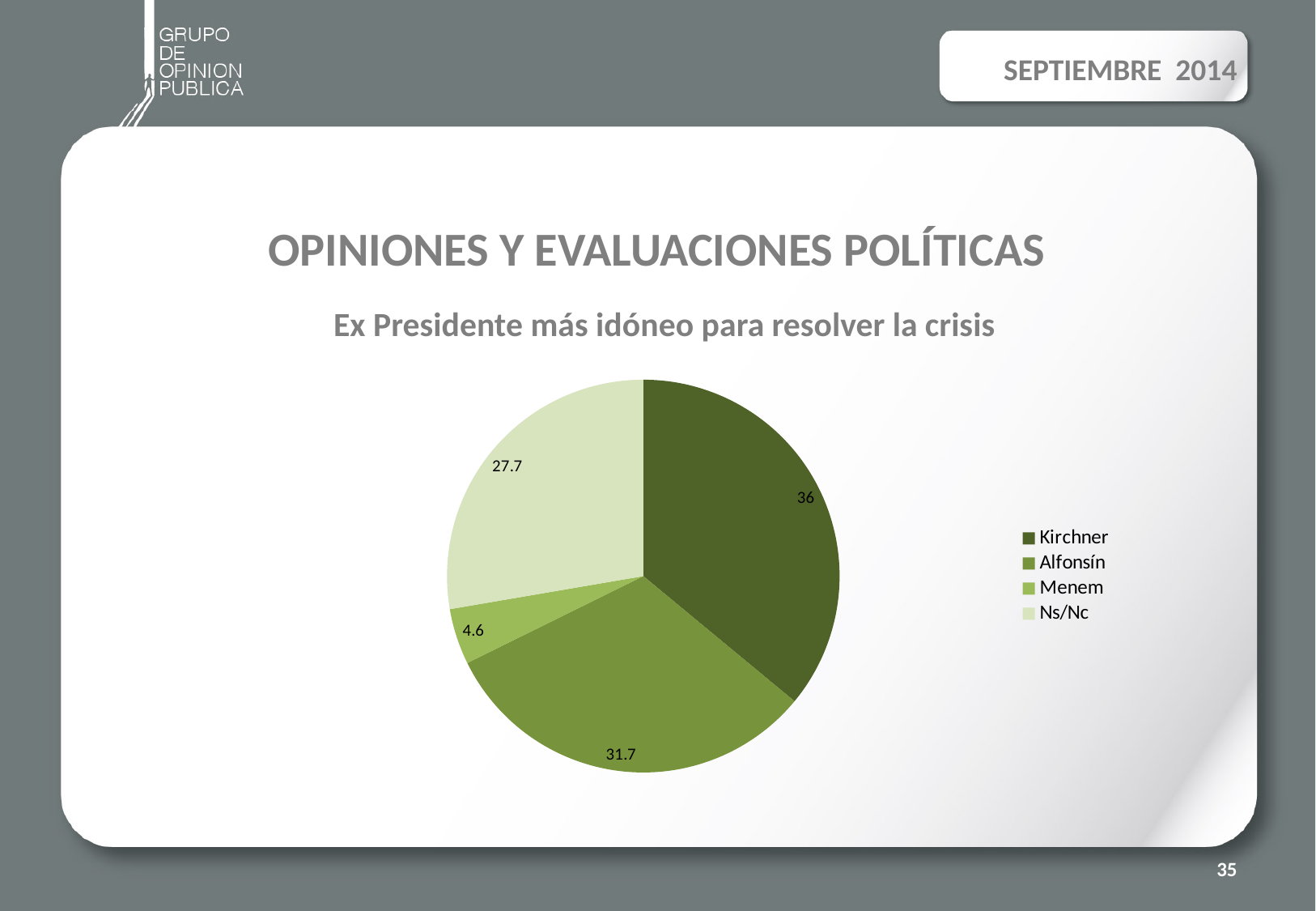
How many slices does the pie chart have? 4 What is the difference between the values for Kirchner and Alfonsín? 4.3 Which category has the largest slice? Kirchner What is the title of the chart? Ex Presidente más idóneo para resolver la crisis Which is larger, the value for Alfonsín or the value for Ns/Nc? Alfonsín What value is shown for Kirchner? 36 What value is shown for Ns/Nc? 27.7 What kind of chart is shown on the slide? Pie chart What value is shown for Alfonsín? 31.7 What is the difference between the values for Ns/Nc and Menem? 23.1 Which category has the smallest slice? Menem What value is shown for Menem? 4.6